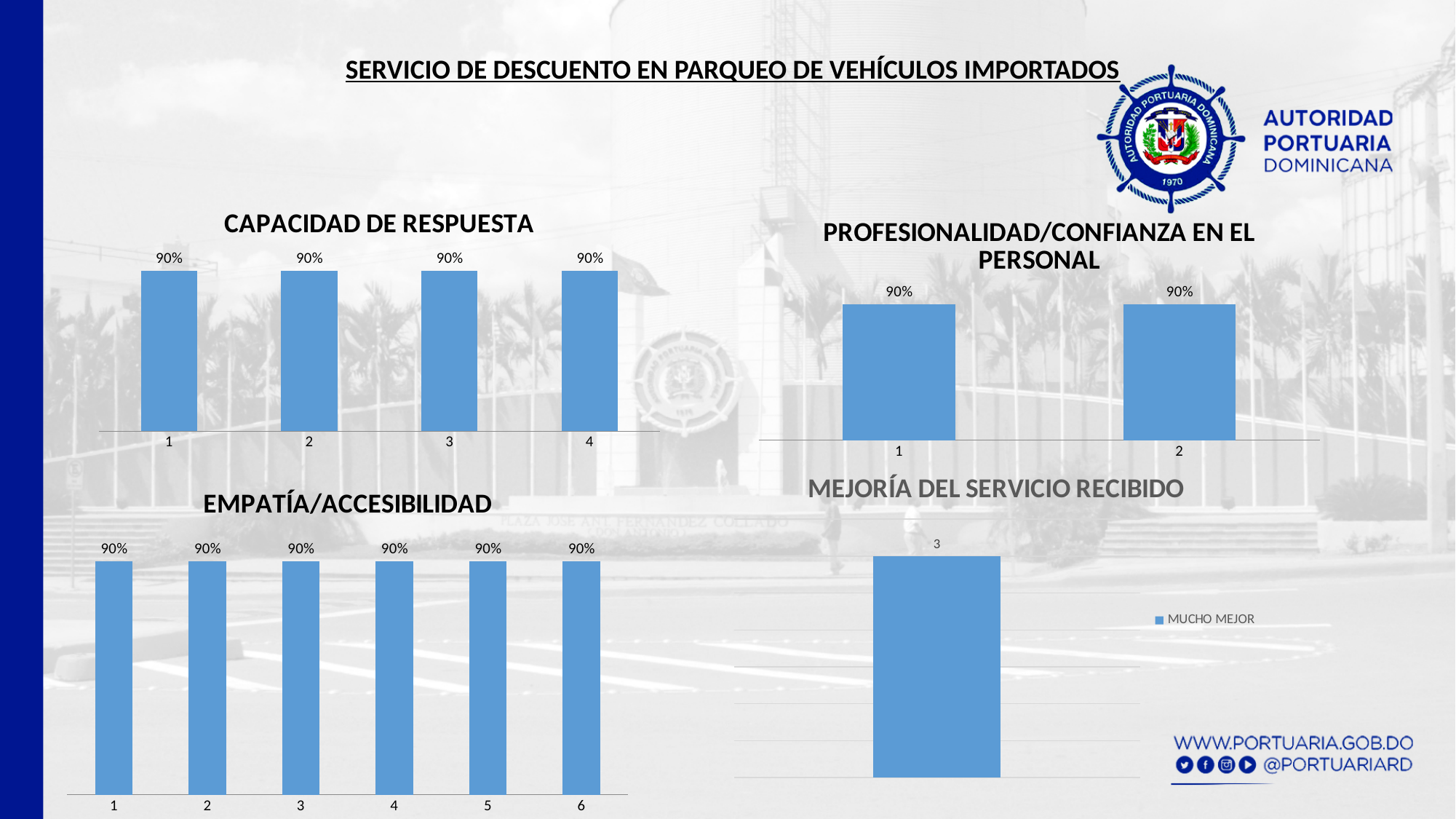
In the MEJORÍA DEL SERVICIO RECIBIDO chart, what is the value of the bar? 3 What type of chart is the CAPACIDAD DE RESPUESTA chart? Bar chart How many bars does the CAPACIDAD DE RESPUESTA chart show? 4 In the EMPATÍA/ACCESIBILIDAD chart, what is the difference between the values for category 1 and category 6? 0% In the EMPATÍA/ACCESIBILIDAD chart, what is the value for category 5? 90% How many series does the legend of the MEJORÍA DEL SERVICIO RECIBIDO chart list? 1 What series does the legend of the MEJORÍA DEL SERVICIO RECIBIDO chart list? MUCHO MEJOR In the CAPACIDAD DE RESPUESTA chart, what is the value for category 1? 90% How many categories does the PROFESIONALIDAD/CONFIANZA EN EL PERSONAL chart have? 2 How many bars does the EMPATÍA/ACCESIBILIDAD chart show? 6 Do the values in the CAPACIDAD DE RESPUESTA chart rise, fall, or stay the same from category 1 to category 4? Stay the same In the PROFESIONALIDAD/CONFIANZA EN EL PERSONAL chart, what is the value for category 2? 90%